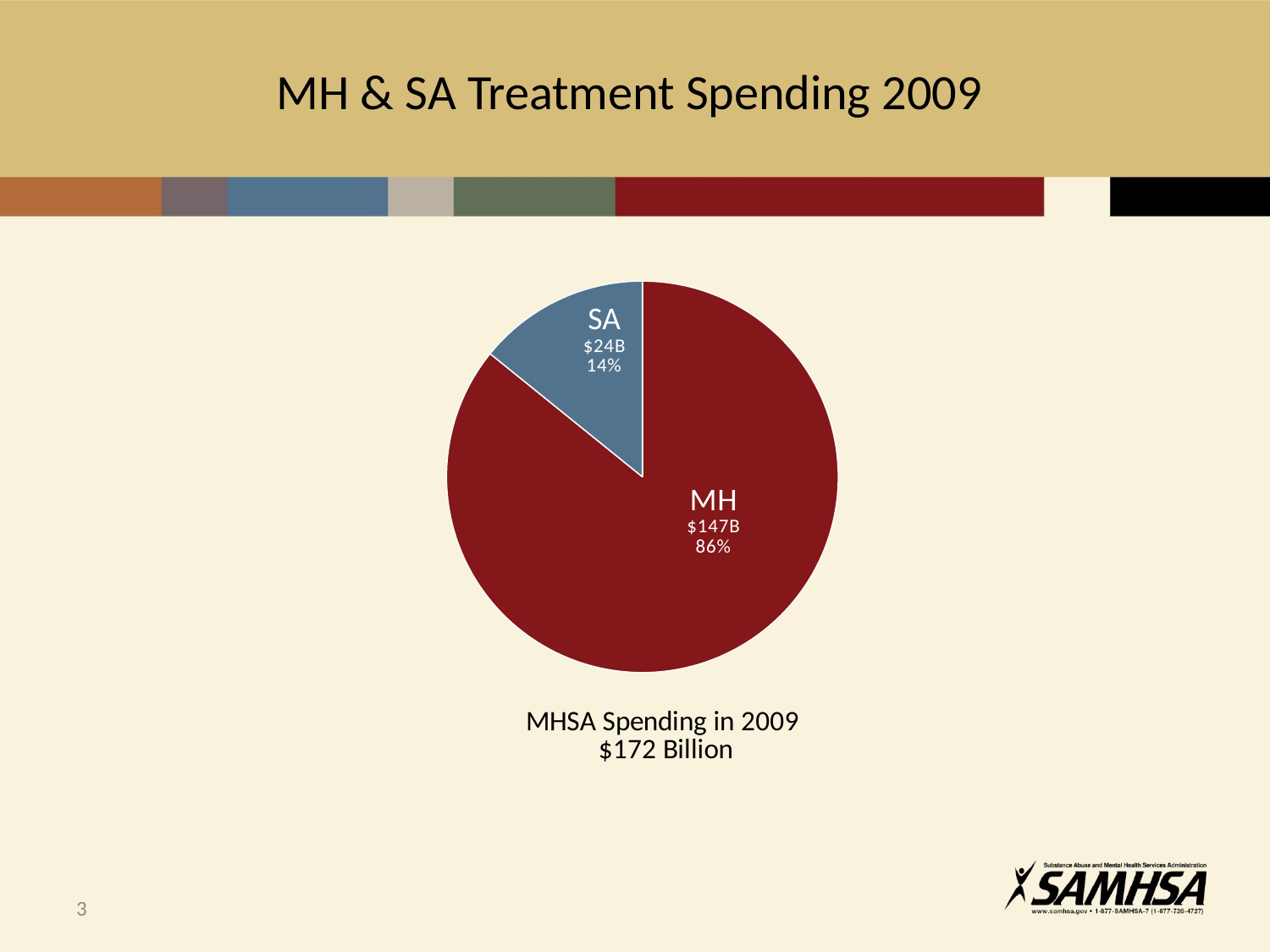
What percentage share of the pie does MH represent? 86% What percentage share of the pie does SA represent? 14% What is the spending value shown for MH? $147B What total MHSA spending in 2009 is stated below the pie chart? $172 Billion Which slice is the smallest in the pie chart? SA Which is larger, spending on MH or spending on SA? MH Which slice is the largest in the pie chart? MH How many slices does the pie chart have? 2 What colour is the SA slice of the pie chart? blue What type of chart is shown on the slide? pie chart What is the spending value shown for SA? $24B What is the difference in spending between MH and SA? $123B